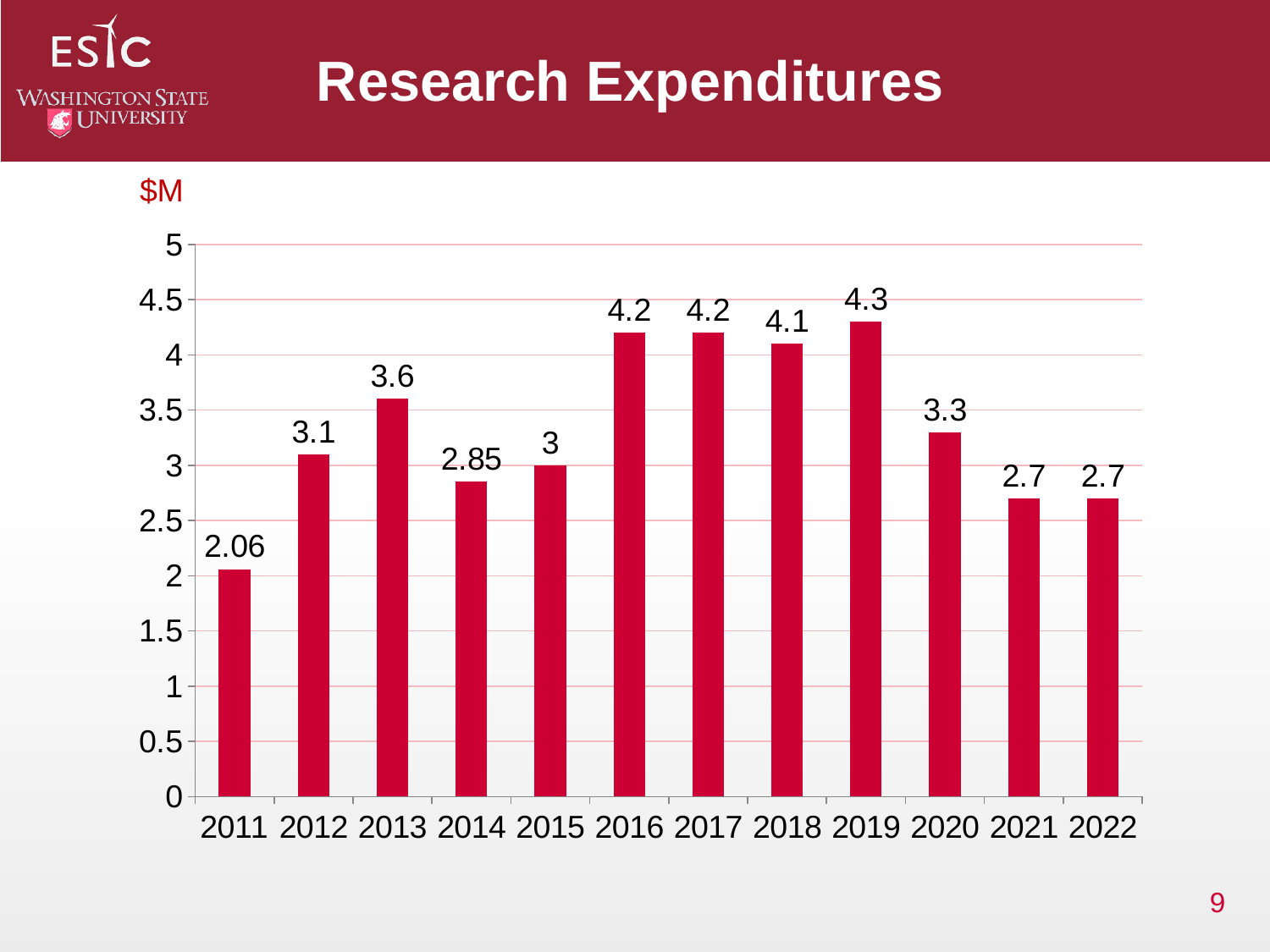
What unit is indicated for the values in the chart? $M What is the research expenditure value for 2014? 2.85 Which year has a larger research expenditure, 2013 or 2020? 2013 What is the difference between the research expenditure in 2013 and in 2014? 0.75 Is the value for 2018 greater or less than 4? greater What is the research expenditure value for 2020? 3.3 What kind of chart is shown on the slide? Bar chart What is the research expenditure value for 2011? 2.06 How many years are shown on the x axis of the chart? 12 Which year has the lowest research expenditure? 2011 Which year has the highest research expenditure? 2019 What is the difference between the research expenditure in 2019 and in 2011? 2.24